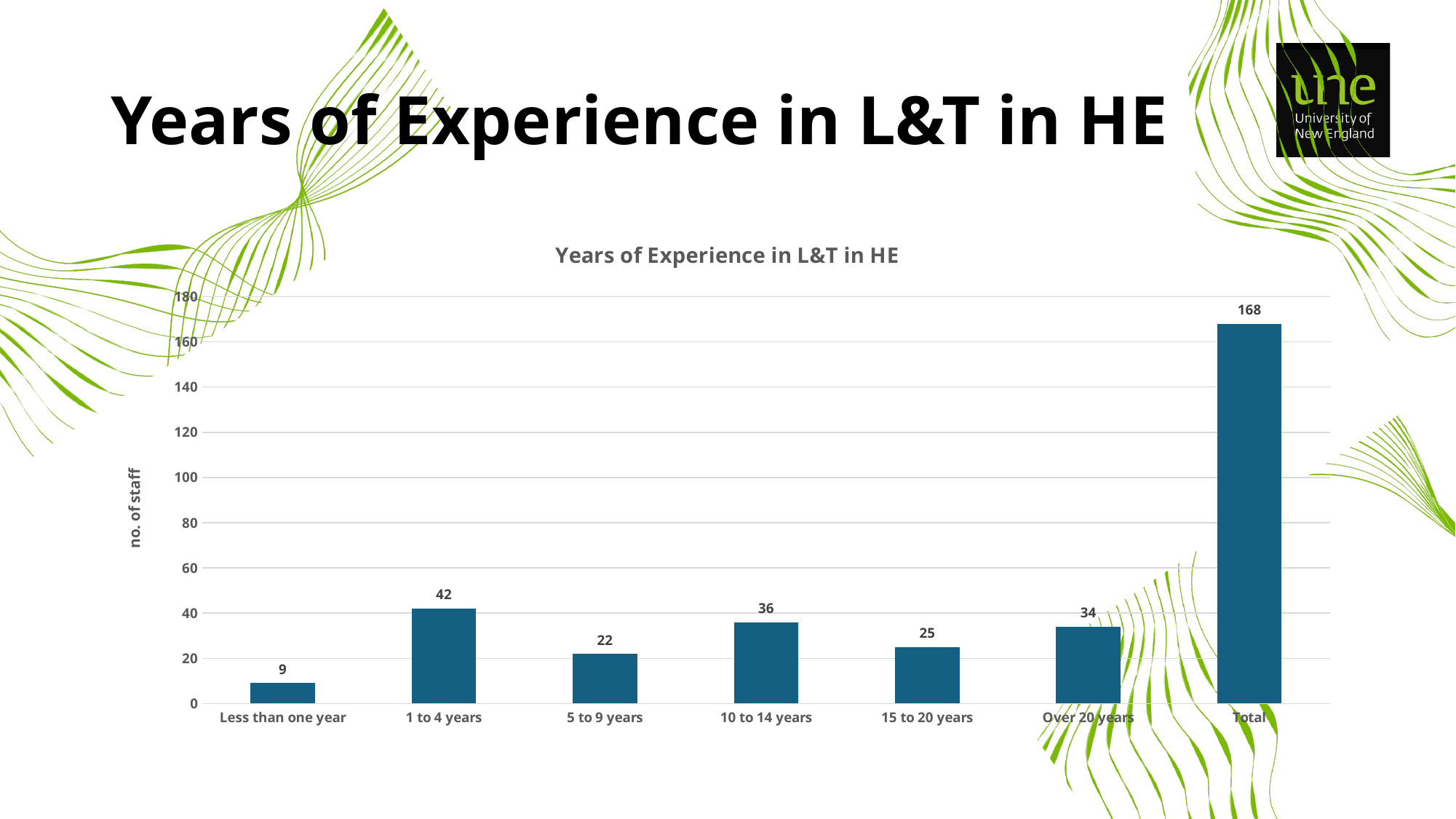
What is the value for Over 20 years? 34 What is the value for Less than one year? 9 Is the value for Total greater or less than 160? greater How many bars are shown in the chart? 7 Which category has the lowest number of staff? Less than one year What is the value for 1 to 4 years? 42 Excluding the Total bar, which category has the highest number of staff? 1 to 4 years What is the label on the vertical axis of the chart? no. of staff What is the value for 15 to 20 years? 25 Which is larger, the value for 10 to 14 years or the value for Over 20 years? 10 to 14 years What kind of chart is shown on the slide? bar chart What is the difference between the values for 1 to 4 years and 5 to 9 years? 20